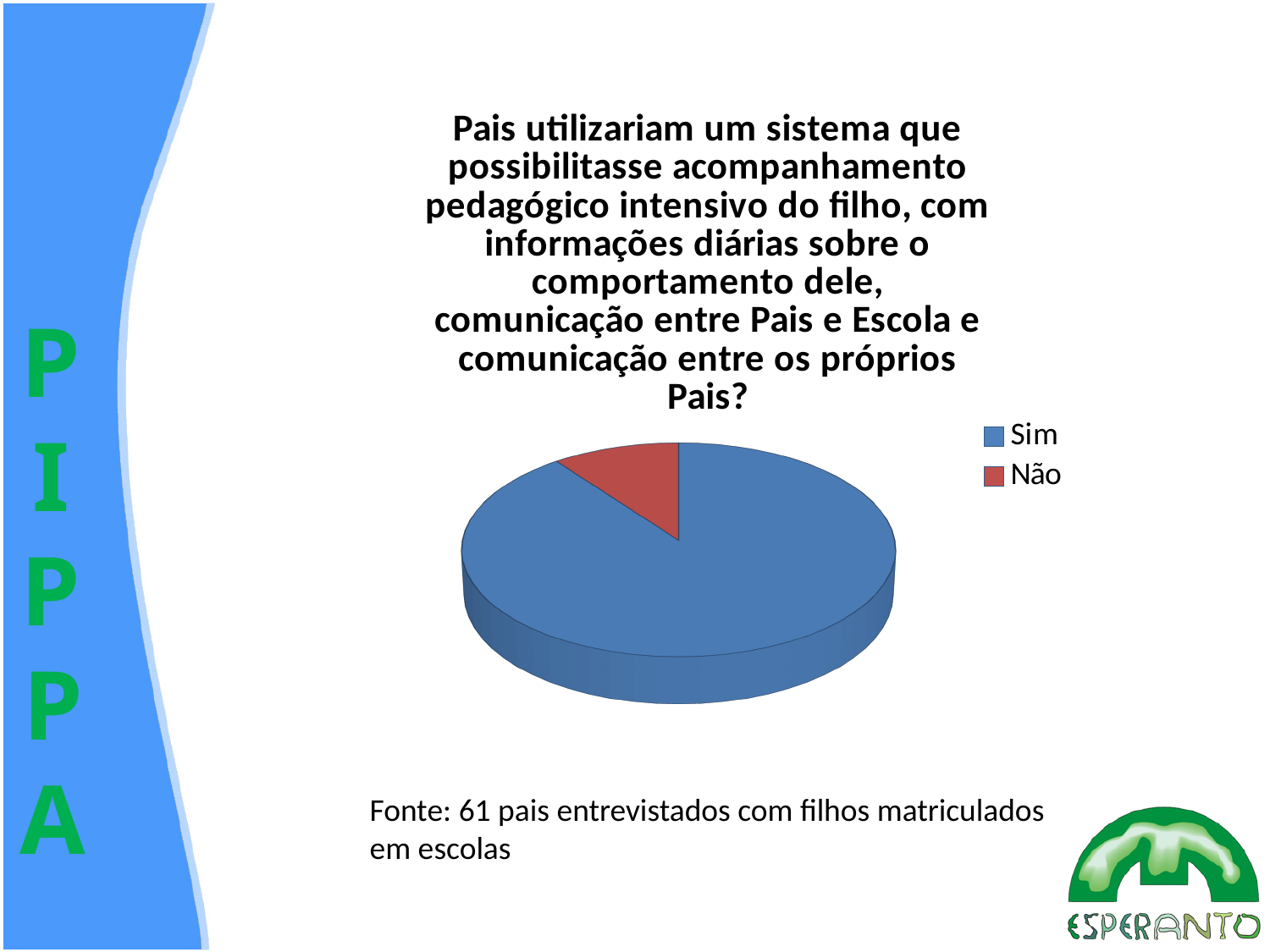
What kind of chart is shown on the slide? pie chart Does the Sim slice take up more or less than half of the pie chart? more Which category has the largest slice of the pie chart? Sim Which category has the smallest slice of the pie chart? Não How many slices does the pie chart have? 2 Which slice is larger in the pie chart, Sim or Não? Sim What colour is the Não slice in the pie chart? red What are the two legend entries of the pie chart? Sim and Não How many entries does the legend of the pie chart list? 2